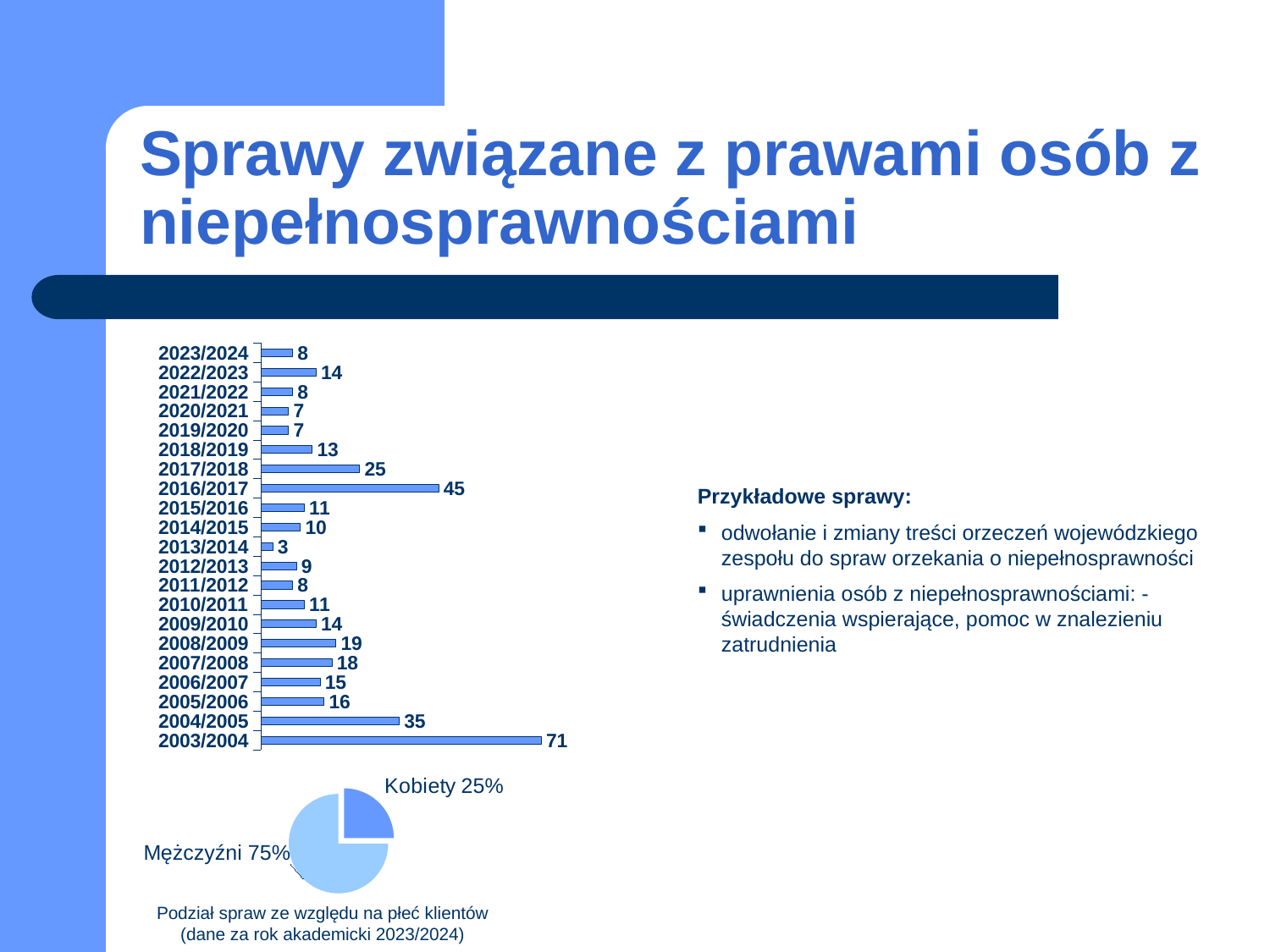
What kind of chart is the chart at the bottom left of the slide? pie chart In the bar chart at the top left of the slide, what is the difference between the values for 2003/2004 and 2004/2005? 36 In the bar chart at the top left of the slide, what is the value for 2016/2017? 45 In the bar chart at the top left of the slide, what is the value for 2008/2009? 19 In the bar chart at the top left of the slide, what is the value for 2023/2024? 8 In the pie chart at the bottom left of the slide, what share is labelled Kobiety? 25% What kind of chart is the chart at the top left of the slide? bar chart In the bar chart at the top left of the slide, which is larger, the value for 2017/2018 or the value for 2018/2019? 2017/2018 In the bar chart at the top left of the slide, which academic year has the lowest value? 2013/2014 In the pie chart at the bottom left of the slide, which slice is larger, Kobiety or Mężczyźni? Mężczyźni In the bar chart at the top left of the slide, which academic year has the highest value? 2003/2004 In the bar chart at the top left of the slide, how many academic years are shown? 21